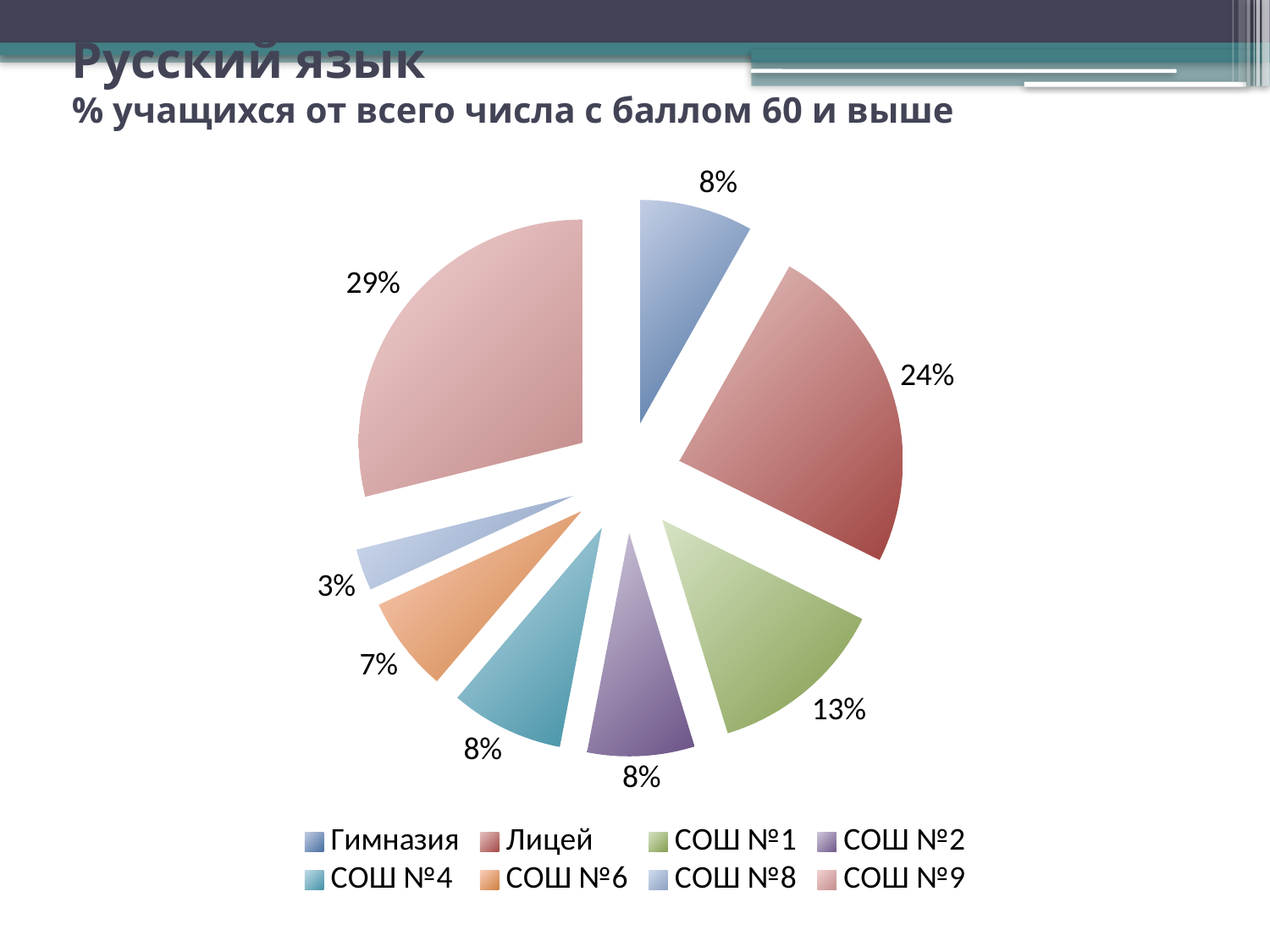
What is the value shown for СОШ №1? 13% Which category has the largest slice of the pie? СОШ №9 What share of the pie does СОШ №9 have? 29% What is the value shown for СОШ №8? 3% What is the subtitle of the chart below the heading 'Русский язык'? % учащихся от всего числа с баллом 60 и выше What share of the pie does Лицей have? 24% Which is larger, the slice for СОШ №1 or the slice for СОШ №6? СОШ №1 How many categories does the legend list? 8 What kind of chart is shown on the slide? pie chart Which category has the smallest slice of the pie? СОШ №8 What is the difference between the values for СОШ №9 and Лицей? 5% What is the value shown for СОШ №6? 7%